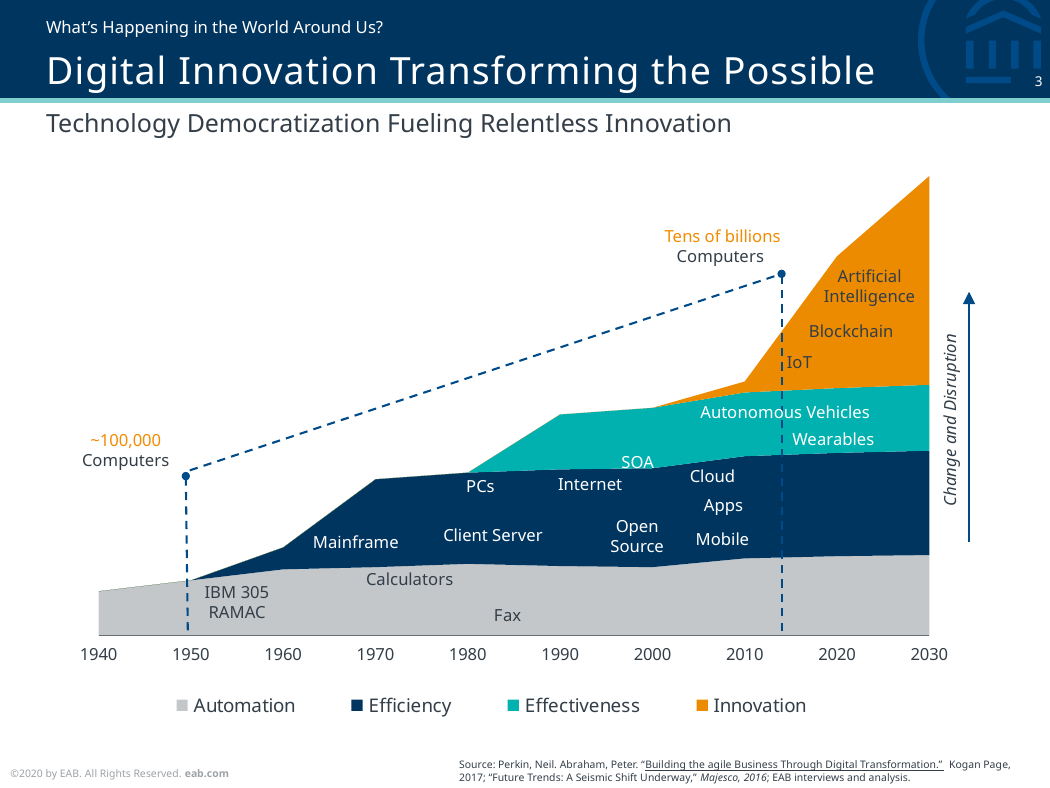
What is the last year shown on the x axis? 2030 What is the first year shown on the x axis? 1940 Which series is plotted at the bottom of the stack? Automation What number of computers is annotated at 1950? ~100,000 Computers Which series area contains the label 'Artificial Intelligence'? Innovation What kind of chart is shown on the slide? Stacked area chart What number of computers is annotated at the later dashed marker near 2014? Tens of billions Computers Which series area contains the label 'Mainframe'? Efficiency How many series does the legend list? 4 Do the stacked areas rise or fall as the years move from 1940 to 2030? Rise How many year labels are shown along the x axis? 10 Which series is plotted at the top of the stack? Innovation